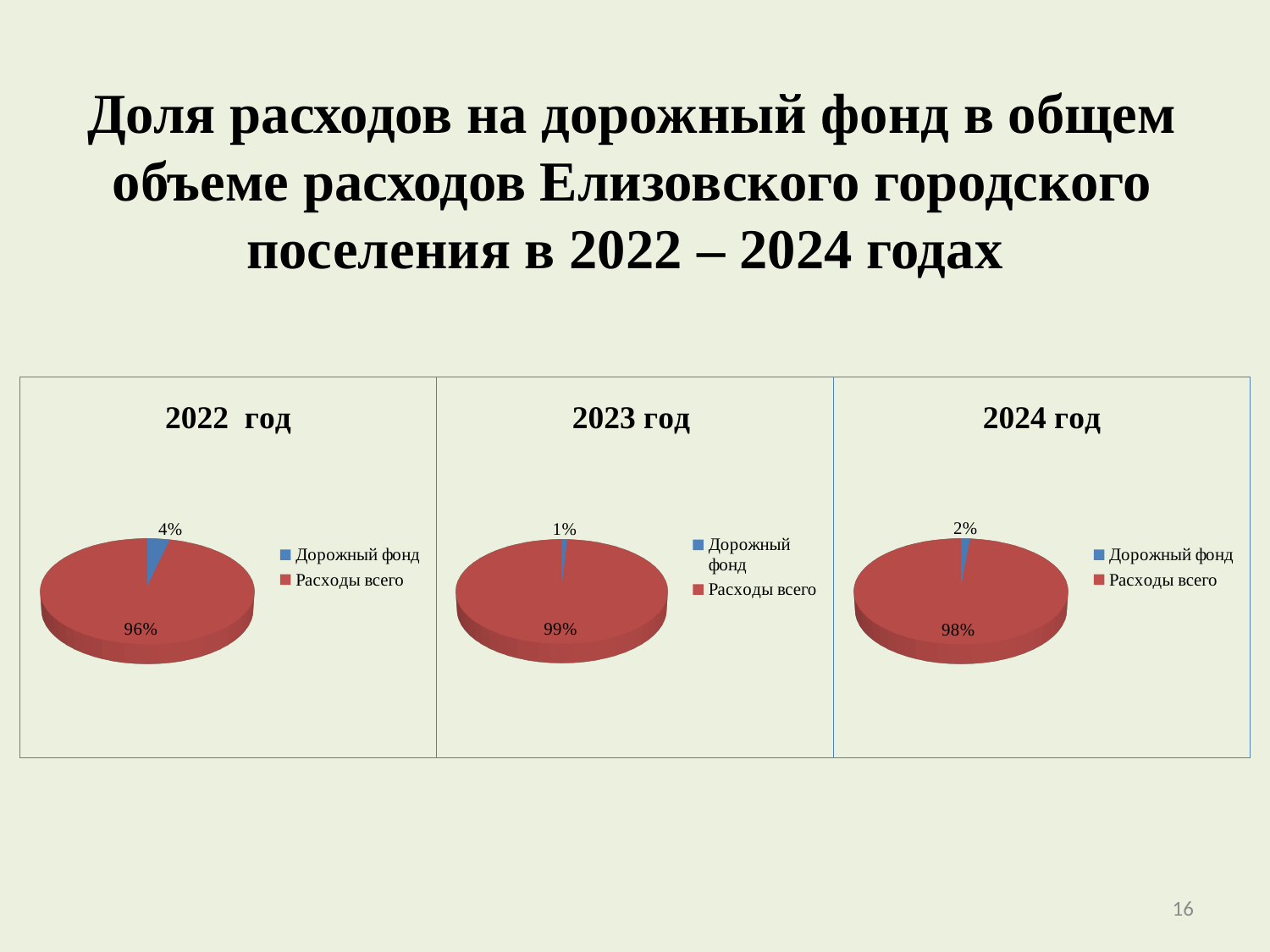
In the "2024 год" chart, what colour is the "Дорожный фонд" slice? Blue In the "2024 год" chart, what share does "Расходы всего" have? 98% In the "2022 год" chart, what share does "Дорожный фонд" have? 4% What kind of chart is the "2023 год" chart? Pie chart In the "2024 год" chart, which slice is the smallest? Дорожный фонд In the "2022 год" chart, what is the difference between the "Расходы всего" share and the "Дорожный фонд" share? 92% How many slices does the "2023 год" chart have? 2 In the "2022 год" chart, what share does "Расходы всего" have? 96% In the "2022 год" chart, which slice is the largest? Расходы всего